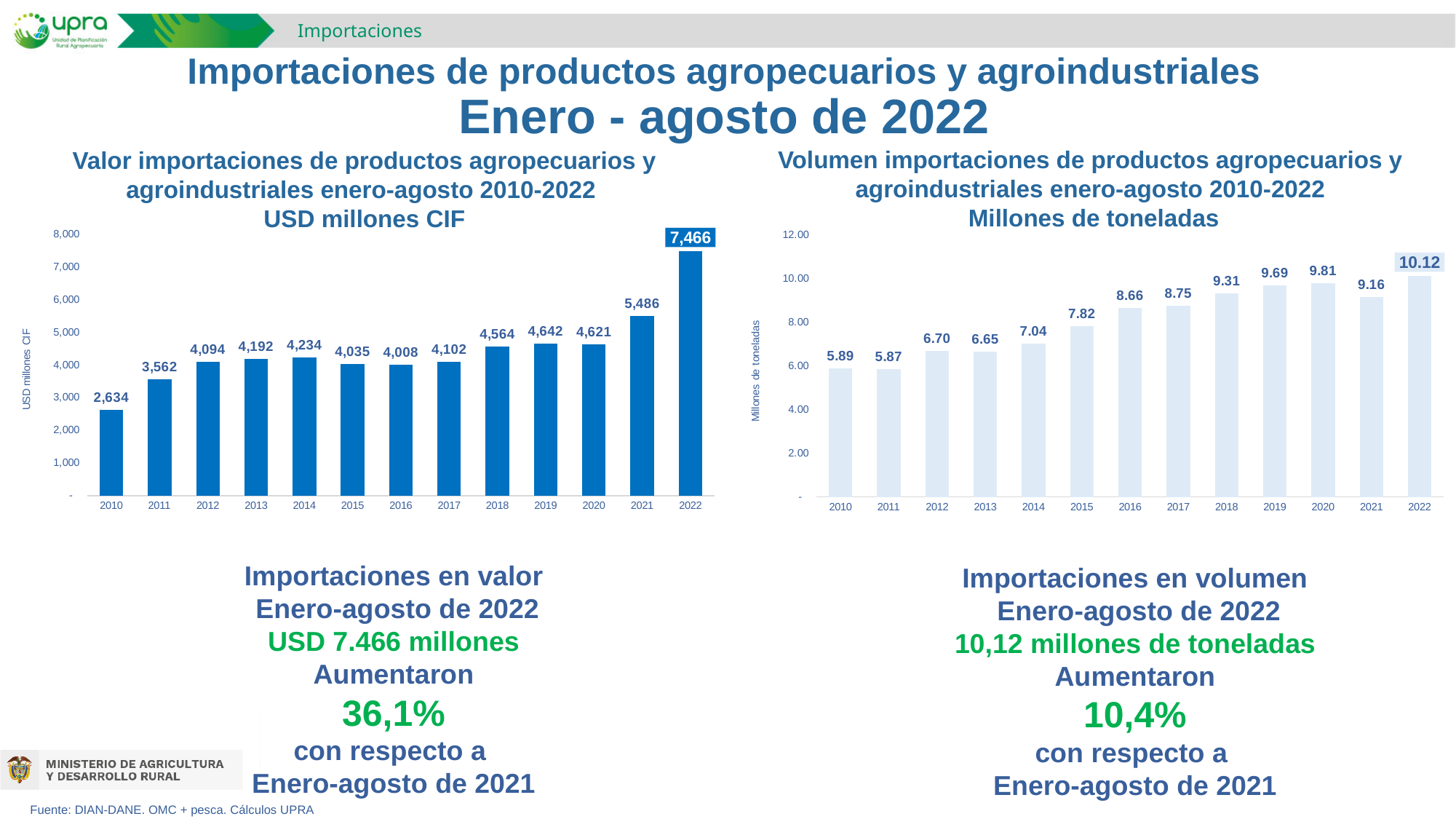
In the right chart (Volumen importaciones, Millones de toneladas), what is the value for 2022? 10.12 In the left chart (Valor importaciones, USD millones CIF), which is larger, the value for 2019 or the value for 2020? 2019 In the left chart (Valor importaciones, USD millones CIF), what is the value for 2010? 2,634 In the right chart (Volumen importaciones, Millones de toneladas), is the value for 2018 greater or less than 8.00? greater In the left chart (Valor importaciones, USD millones CIF), which year has the lowest value? 2010 In the right chart (Volumen importaciones, Millones de toneladas), which year has the highest value? 2022 In the left chart (Valor importaciones, USD millones CIF), what is the difference between the 2022 and 2021 values? 1,980 In the right chart (Volumen importaciones, Millones de toneladas), what is the value for 2015? 7.82 In the left chart (Valor importaciones, USD millones CIF), how many years are plotted? 13 What type of chart is the left chart (Valor importaciones, USD millones CIF)? Bar chart In the right chart (Volumen importaciones, Millones de toneladas), what is the difference between the 2020 and 2021 values? 0.65 In the left chart (Valor importaciones, USD millones CIF), what is the value for 2022? 7,466